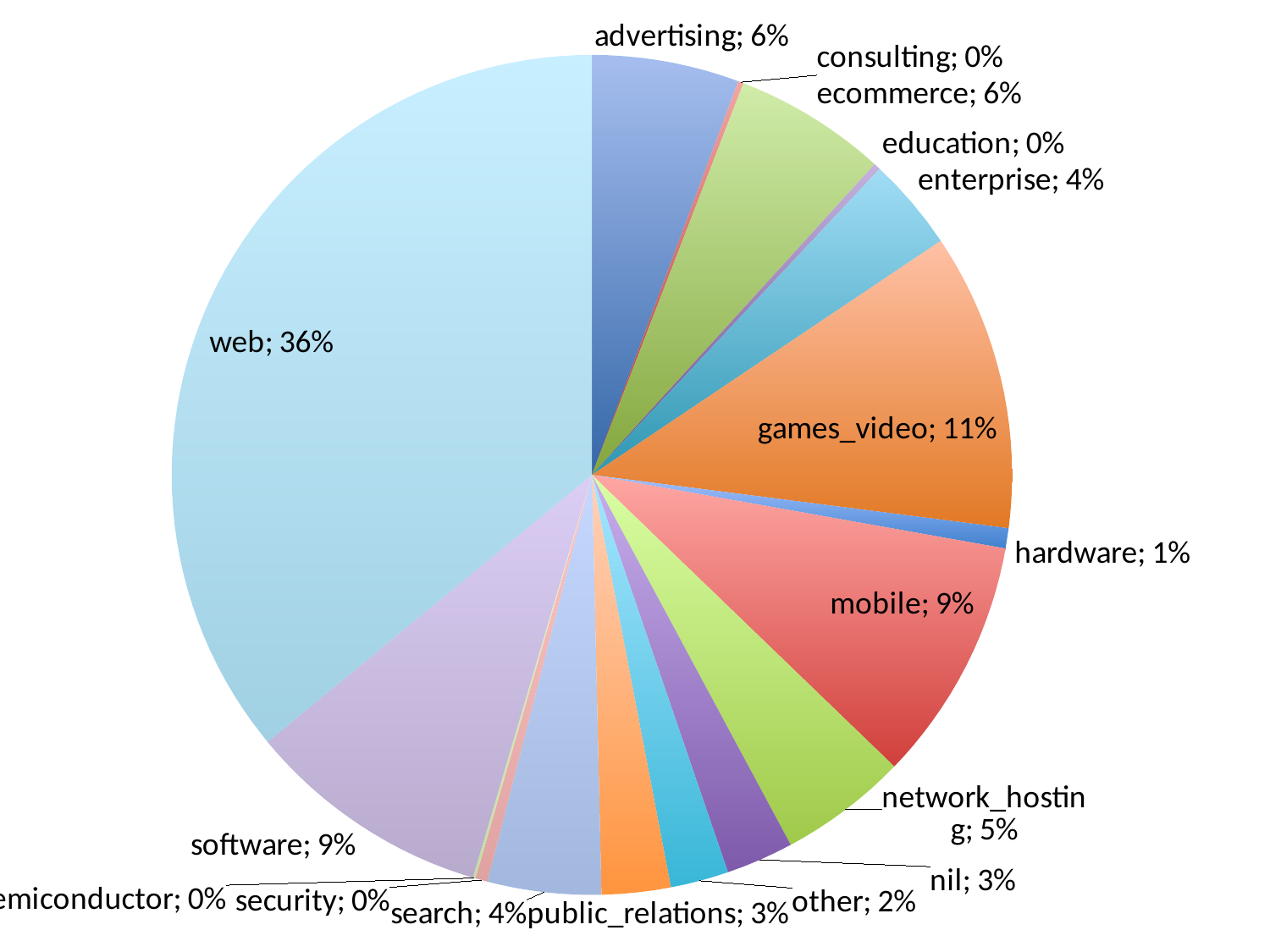
Which is larger, games_video or mobile? games_video What kind of chart is shown on the slide? pie chart What is the difference in percentage points between web and games_video? 25 What is the value shown for network_hosting? 5% What is the difference in percentage points between software and search? 5 What share of the pie does the web slice represent? 36% What is the value shown for public_relations? 3% Which category has the largest slice of the pie? web What is the value shown for hardware? 1% What is the value shown for games_video? 11% What is the value shown for mobile? 9% Which is larger, network_hosting or nil? network_hosting